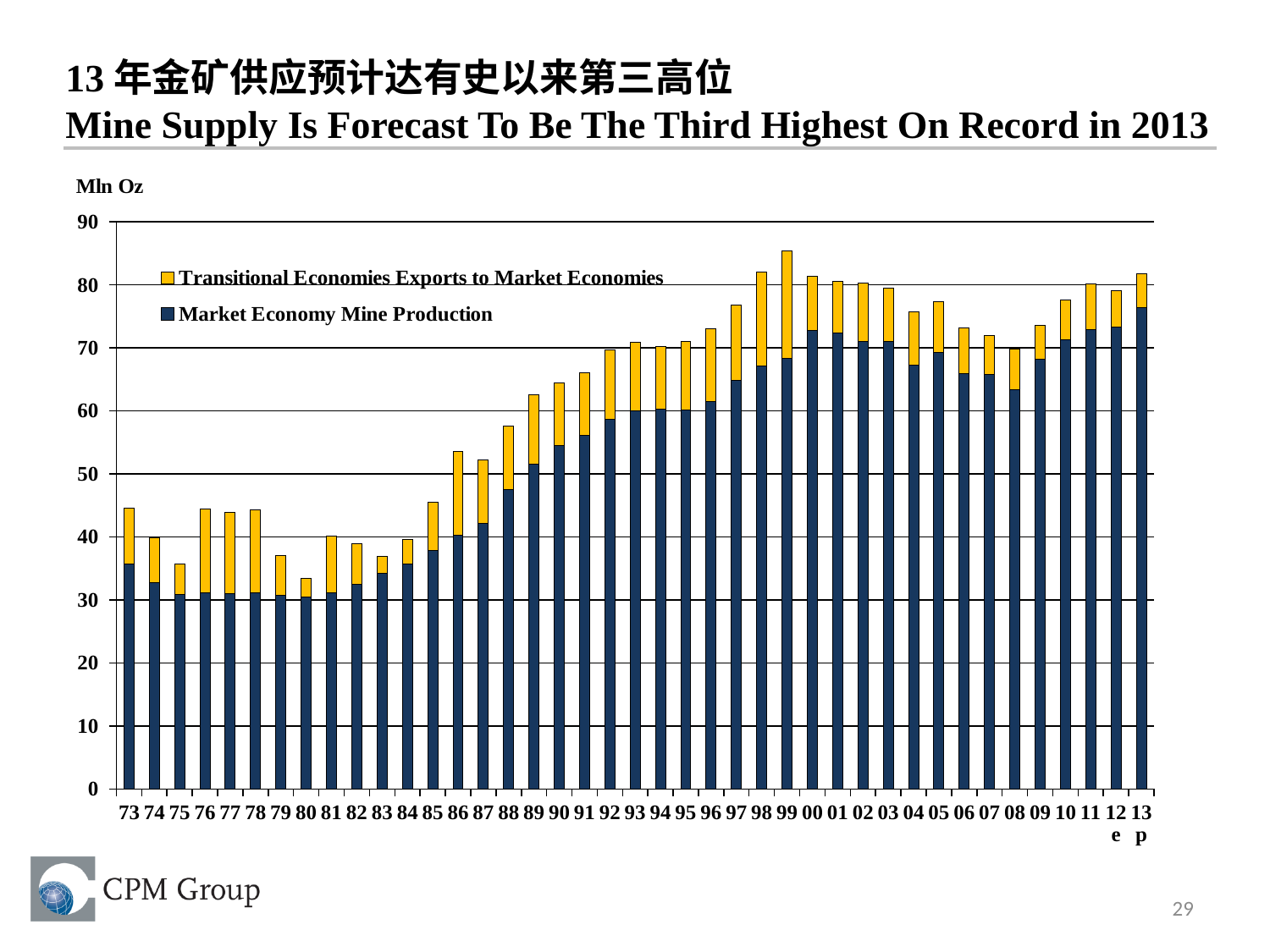
Is the total value for 99 greater or less than 80? greater Which year has the highest total mine supply? 99 What kind of chart is shown on the slide? Stacked bar chart Is the total value for 80 greater or less than 40? less How many years (bars) are plotted on the chart? 41 Do the total values rise or fall from 80 to 99? Rise Is the total value for 13p greater or less than 80? greater Which year has the lowest total mine supply? 80 How many series does the legend list? 2 Which year has a larger total mine supply, 99 or 73? 99 What unit is shown on the y axis of the chart? Mln Oz